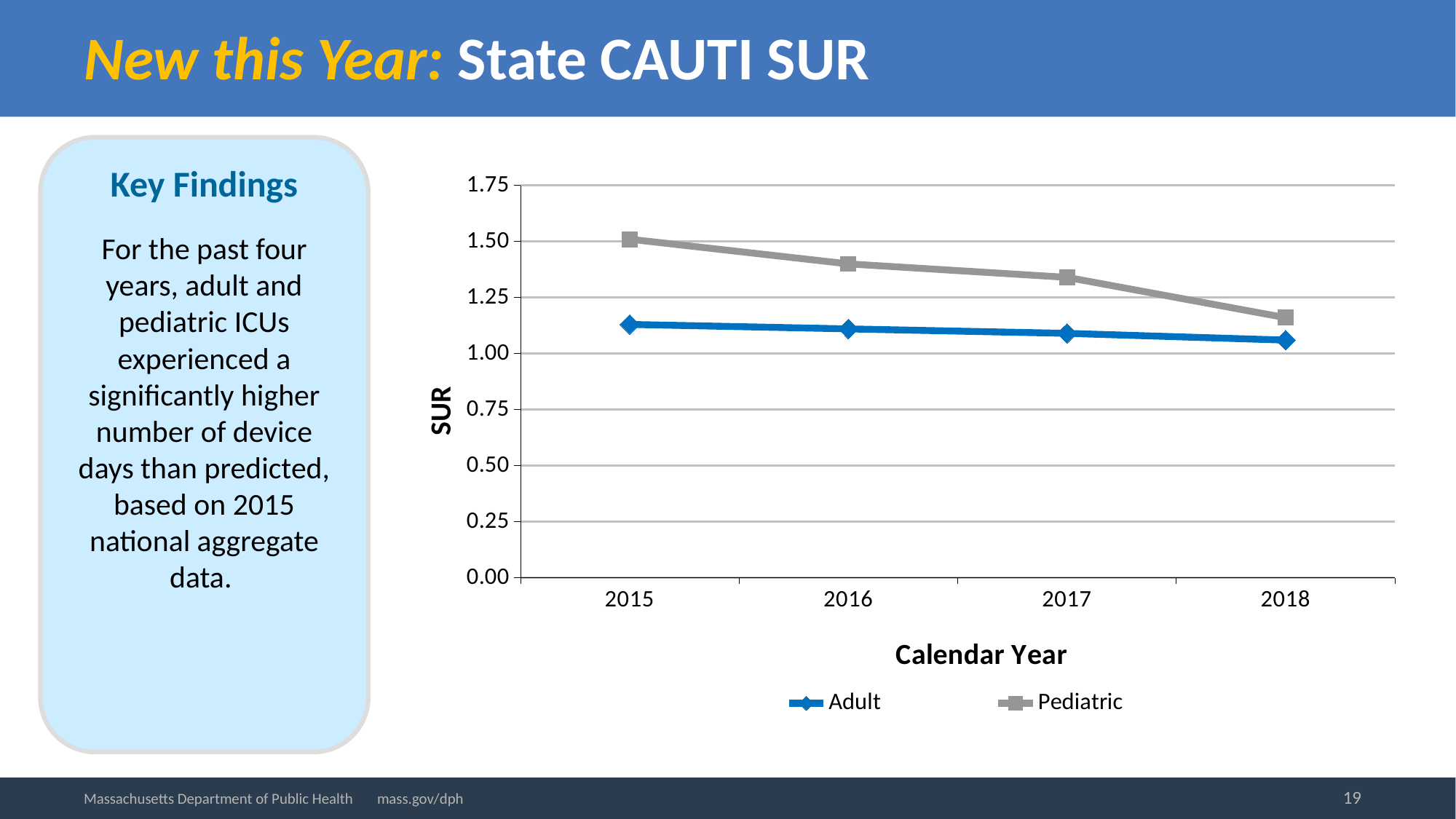
In 2015, which series has the higher SUR, Adult or Pediatric? Pediatric Is the Pediatric SUR for 2015 greater or less than 1.25? greater Is the Adult SUR for 2015 greater or less than 1.00? greater In which year is the Pediatric SUR lowest? 2018 Is the Pediatric SUR for 2018 greater or less than 1.25? less What is the title of the x axis? Calendar Year In which year is the Pediatric SUR highest? 2015 Does the Adult SUR rise or fall from 2015 to 2018? fall How many series does the legend list? 2 How many calendar years are plotted on the x axis? 4 What kind of chart is shown on the slide? line chart Does the Pediatric SUR rise or fall from 2015 to 2018? fall